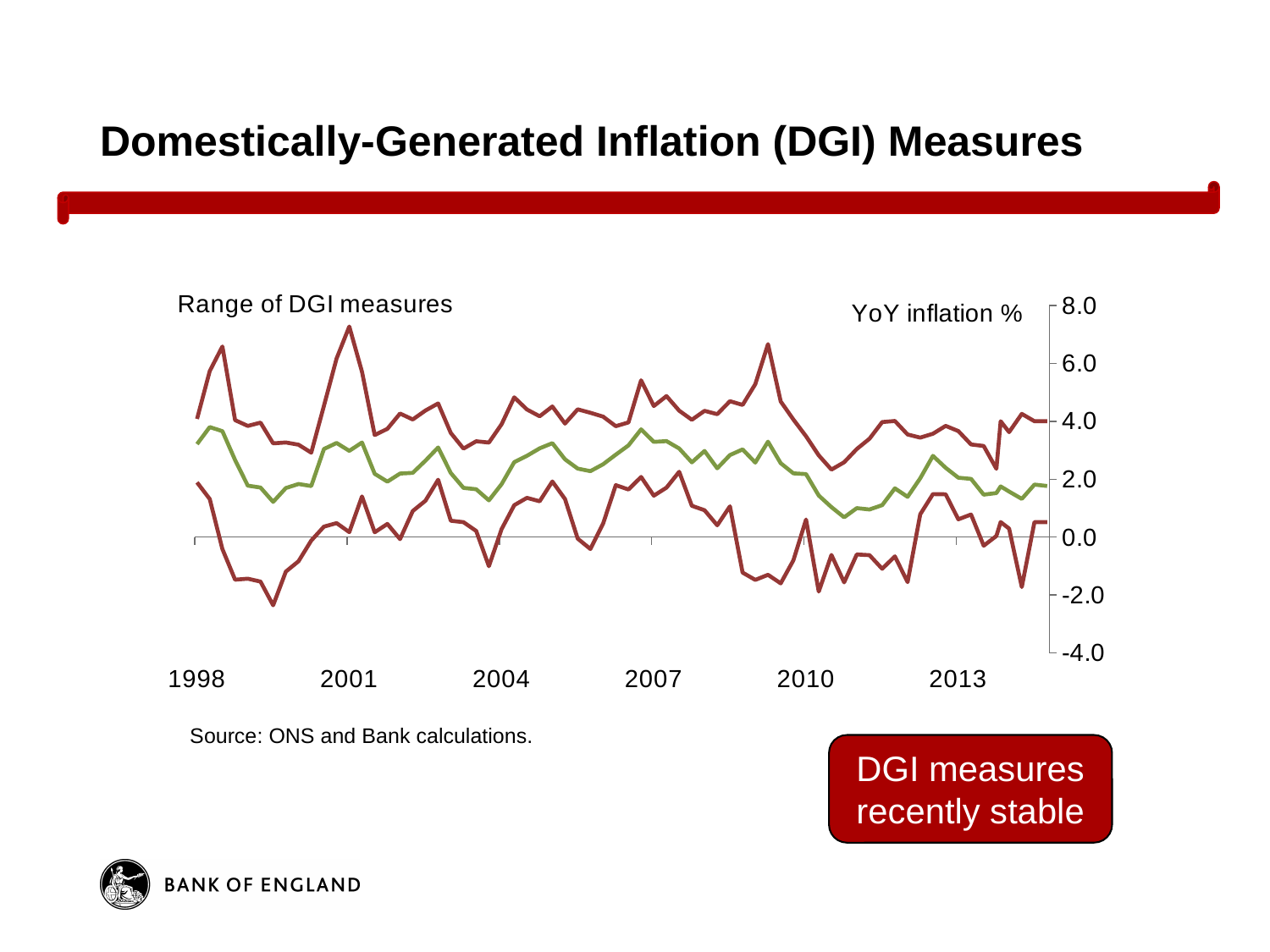
Is the lowest point of the lower red line around 1999-2000 greater or less than -1.0? less Is the green line's peak around 2007 greater or less than 3.0? greater Does the green line rise or fall between 2007 and 2011? fall Is the peak of the upper red line around 2009 greater or less than 6.0? greater How many year labels are shown on the horizontal axis? 6 What kind of chart is shown on the slide? Line chart Does the upper red line rise or fall between its 2001 peak and 2004? fall What unit label is shown at the top of the vertical axis? YoY inflation % What is the title of the chart? Range of DGI measures How many lines are plotted on the chart? 3